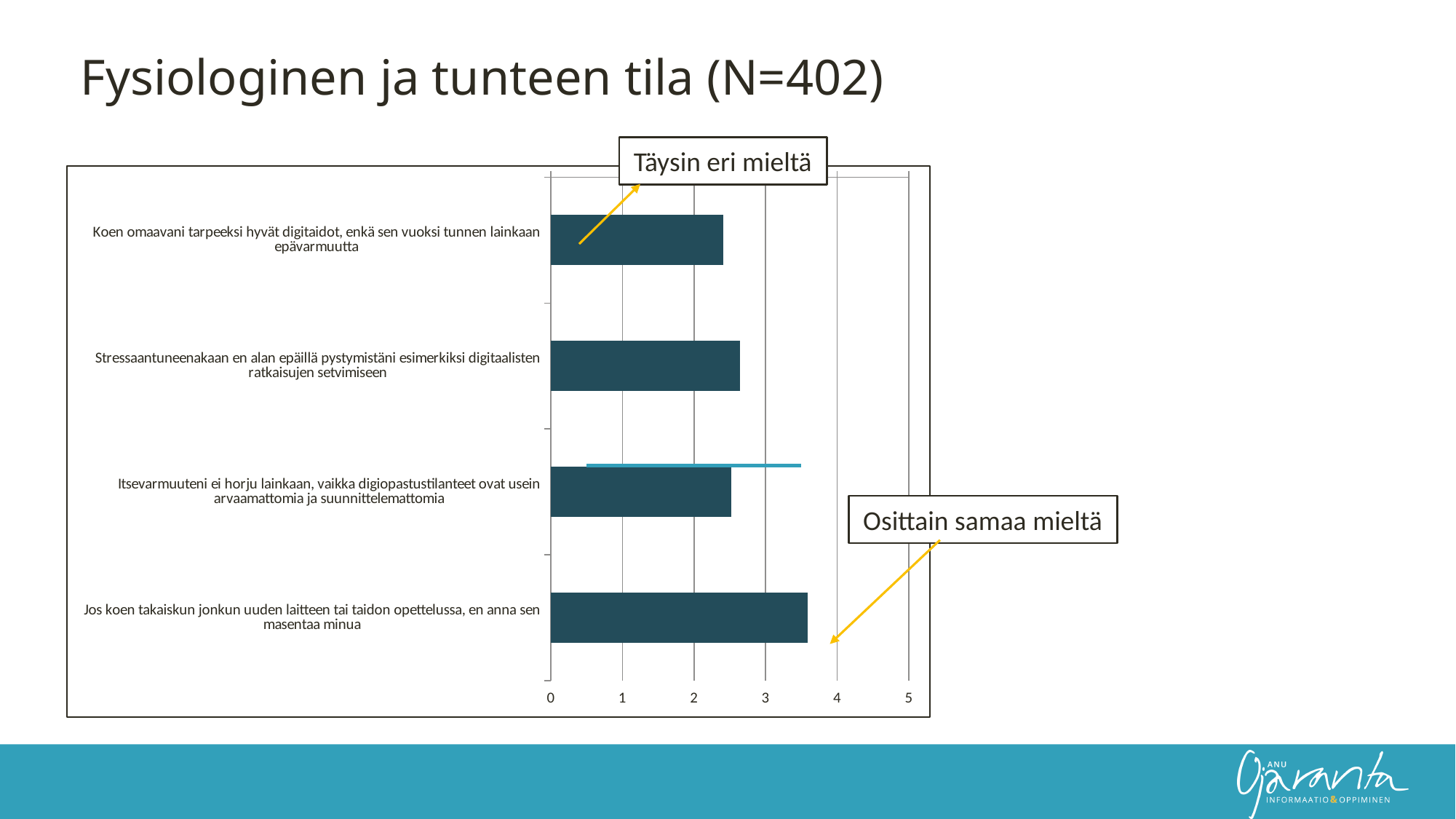
Is the value for "Jos koen takaiskun jonkun uuden laitteen tai taidon opettelussa, en anna sen masentaa minua" greater or less than 3? greater Which has the larger value: "Jos koen takaiskun jonkun uuden laitteen tai taidon opettelussa, en anna sen masentaa minua" or "Koen omaavani tarpeeksi hyvät digitaidot, enkä sen vuoksi tunnen lainkaan epävarmuutta"? Jos koen takaiskun jonkun uuden laitteen tai taidon opettelussa, en anna sen masentaa minua Is the value for "Koen omaavani tarpeeksi hyvät digitaidot, enkä sen vuoksi tunnen lainkaan epävarmuutta" greater or less than 3? less What is the title of the slide containing the chart? Fysiologinen ja tunteen tila (N=402) What kind of chart is shown on the slide? bar chart What is the maximum value shown on the horizontal axis of the chart? 5 Is the value for "Jos koen takaiskun jonkun uuden laitteen tai taidon opettelussa, en anna sen masentaa minua" greater or less than 4? less Which statement has the highest value in the chart? Jos koen takaiskun jonkun uuden laitteen tai taidon opettelussa, en anna sen masentaa minua How many categories (statements) are plotted in the chart? 4